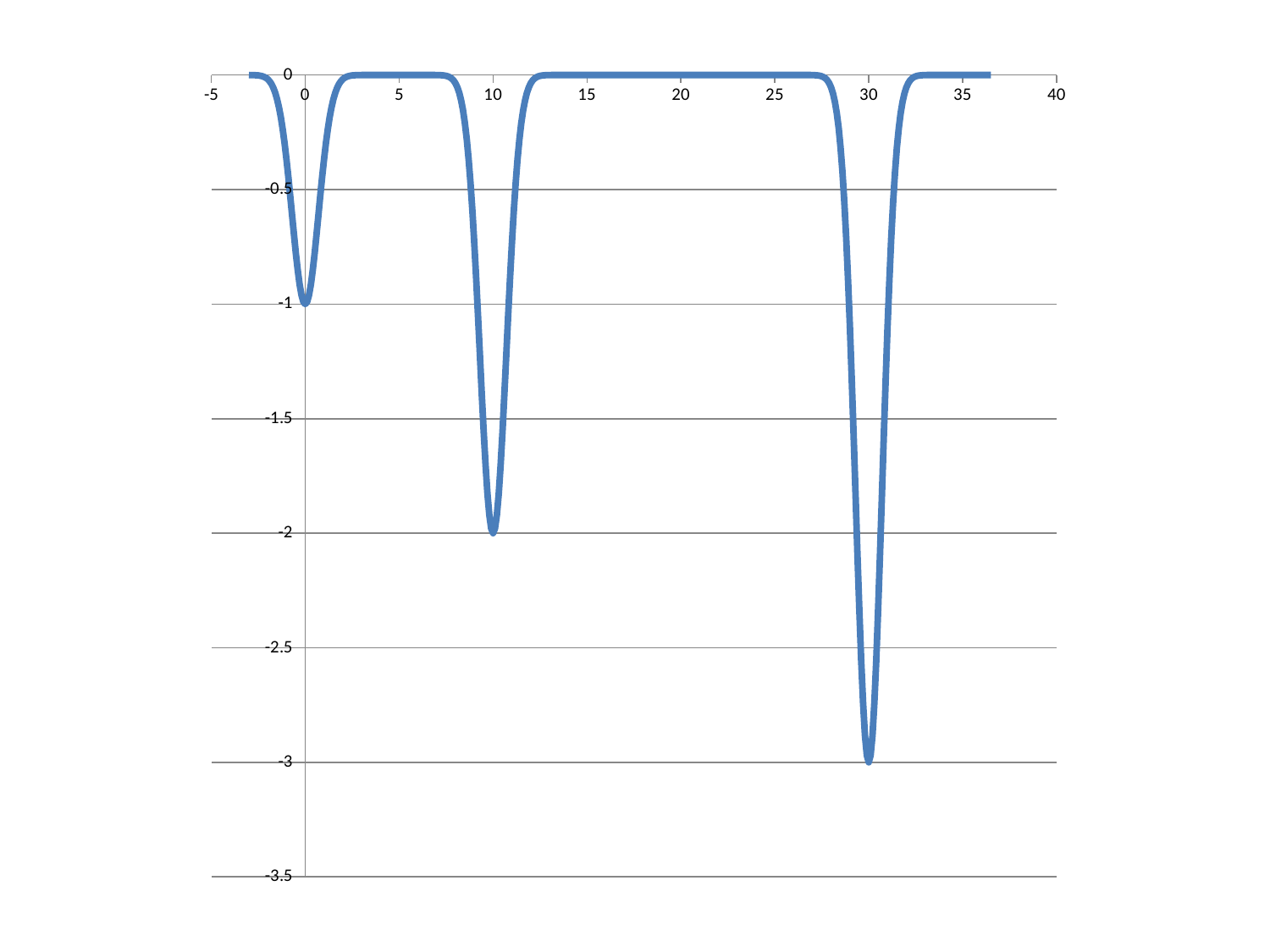
How many dips (troughs) does the line show? 3 Which dip is deeper, the one at x = 10 or the one at x = 30? x = 30 What kind of chart is shown on the slide? line chart What value does the line reach at the dip near x = 10? -2 What value does the line reach at the dip near x = 30? -3 What is the lowest value the line reaches? -3 What is the difference between the depth of the dip at x = 0 and the dip at x = 30? 2 Do the dips get deeper or shallower as x increases? deeper Is the value of the line at x = 20 greater or less than -0.5? greater What value does the line reach at the dip near x = 0? -1 At which x value does the line reach its lowest point? 30 Is the value at the dip near x = 10 greater or less than -1.5? less